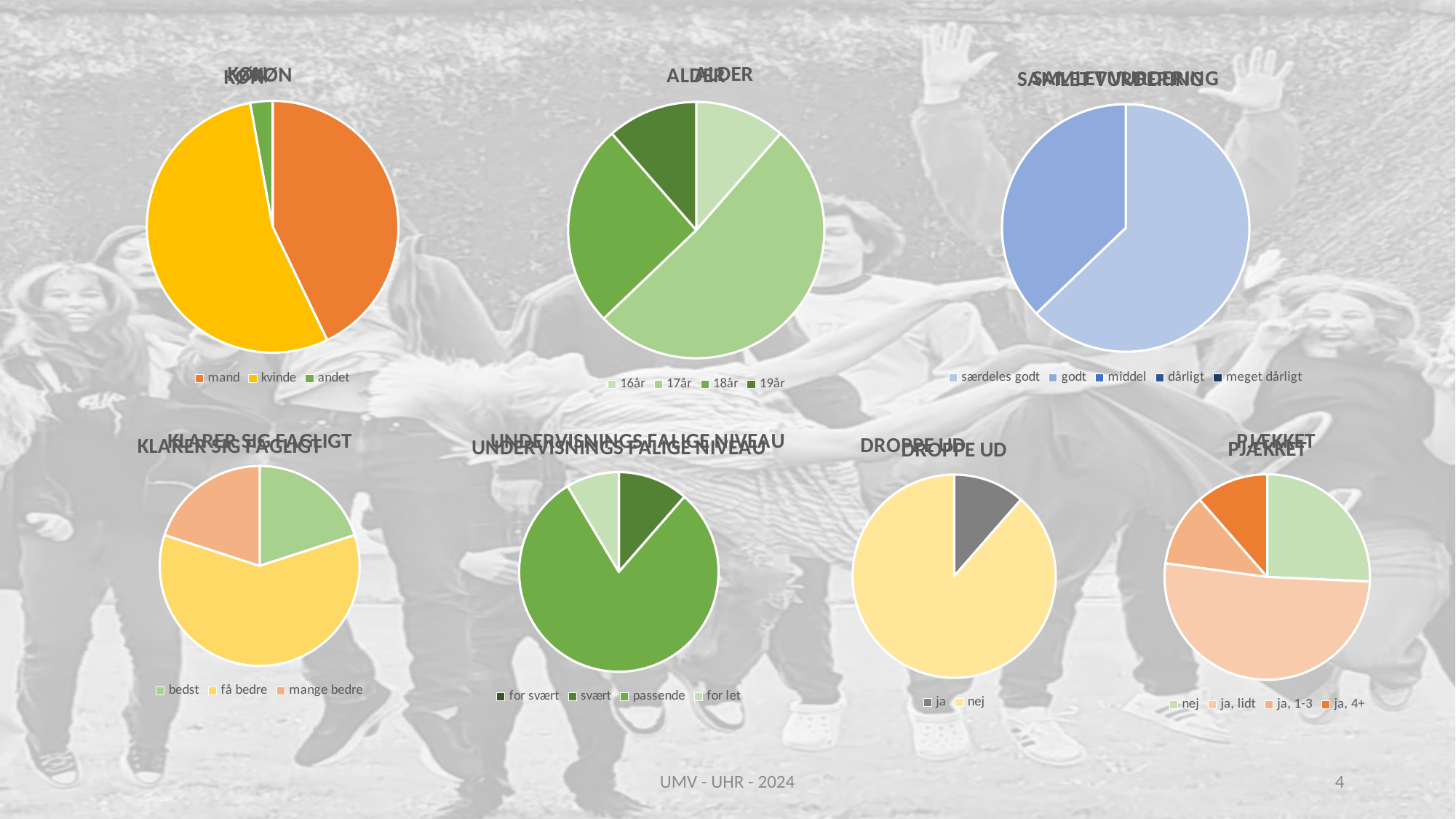
In the ALDER chart, which age group has the largest slice? 17år In the SAMLET VURDERING chart, which category has the largest slice? særdeles godt What kind of chart is the KØN chart? pie chart In the KØN chart, which category has the largest slice? kvinde In the DROPPE UD chart, which slice is larger, ja or nej? nej In the KØN chart, which category has the smallest slice? andet In the ALDER chart, which slice is larger, 17år or 18år? 17år How many categories does the legend of the SAMLET VURDERING chart list? 5 How many pie charts are shown on the slide? 7 How many categories does the legend of the ALDER chart list? 4